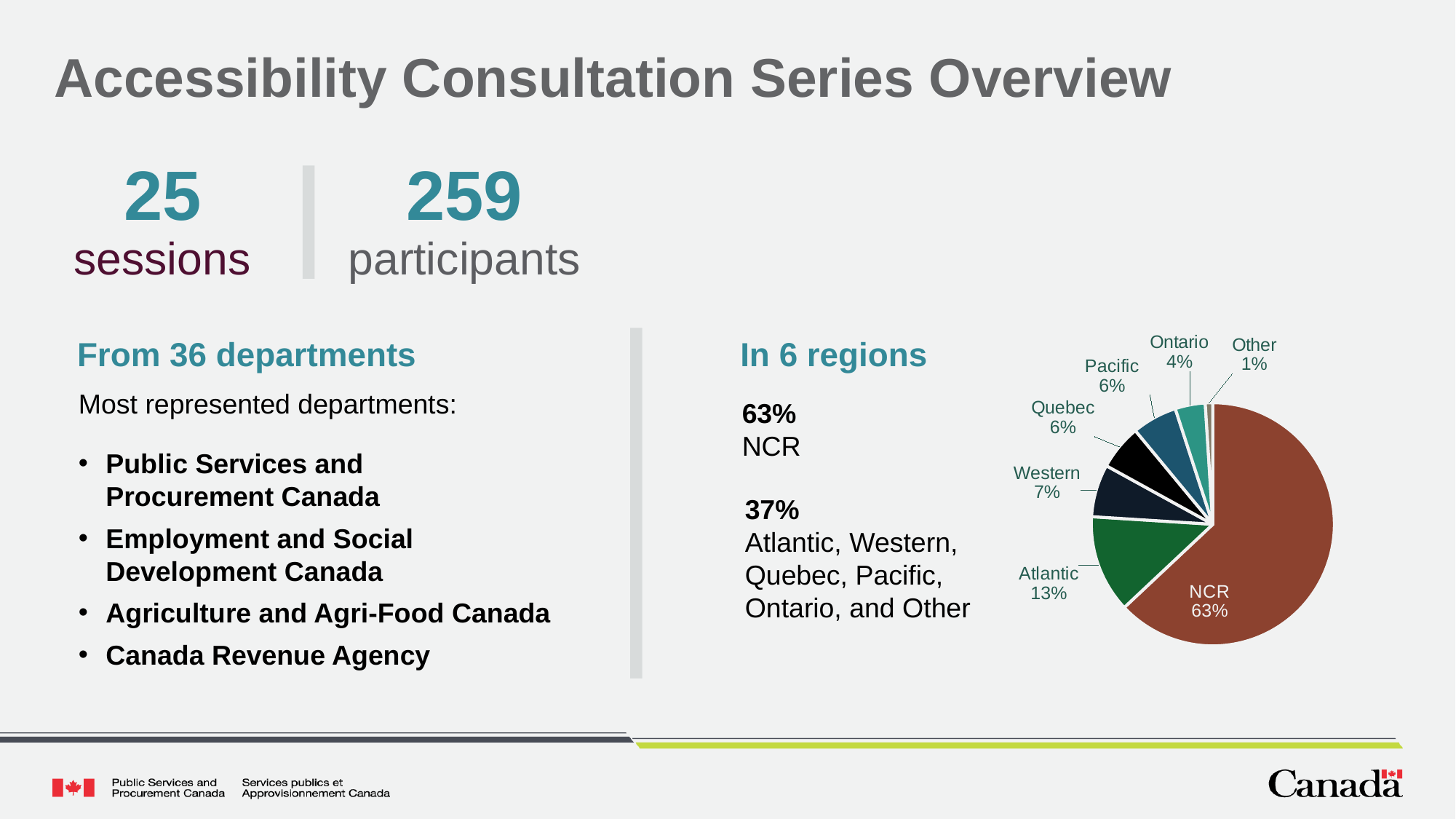
What percentage is shown for Atlantic in the pie chart? 13% How many slices does the pie chart have? 7 Which region has the smallest slice in the pie chart? Other What colour is the NCR slice in the pie chart? brown What is the difference in percentage points between NCR and Atlantic in the pie chart? 50 What share of the pie chart does NCR represent? 63% Which region has the largest slice in the pie chart? NCR What is the combined percentage of Quebec and Pacific in the pie chart? 12% What type of chart is shown on the slide? pie chart What percentage is shown for Western in the pie chart? 7% What percentage is shown for Ontario in the pie chart? 4% Which is larger in the pie chart, Western or Ontario? Western